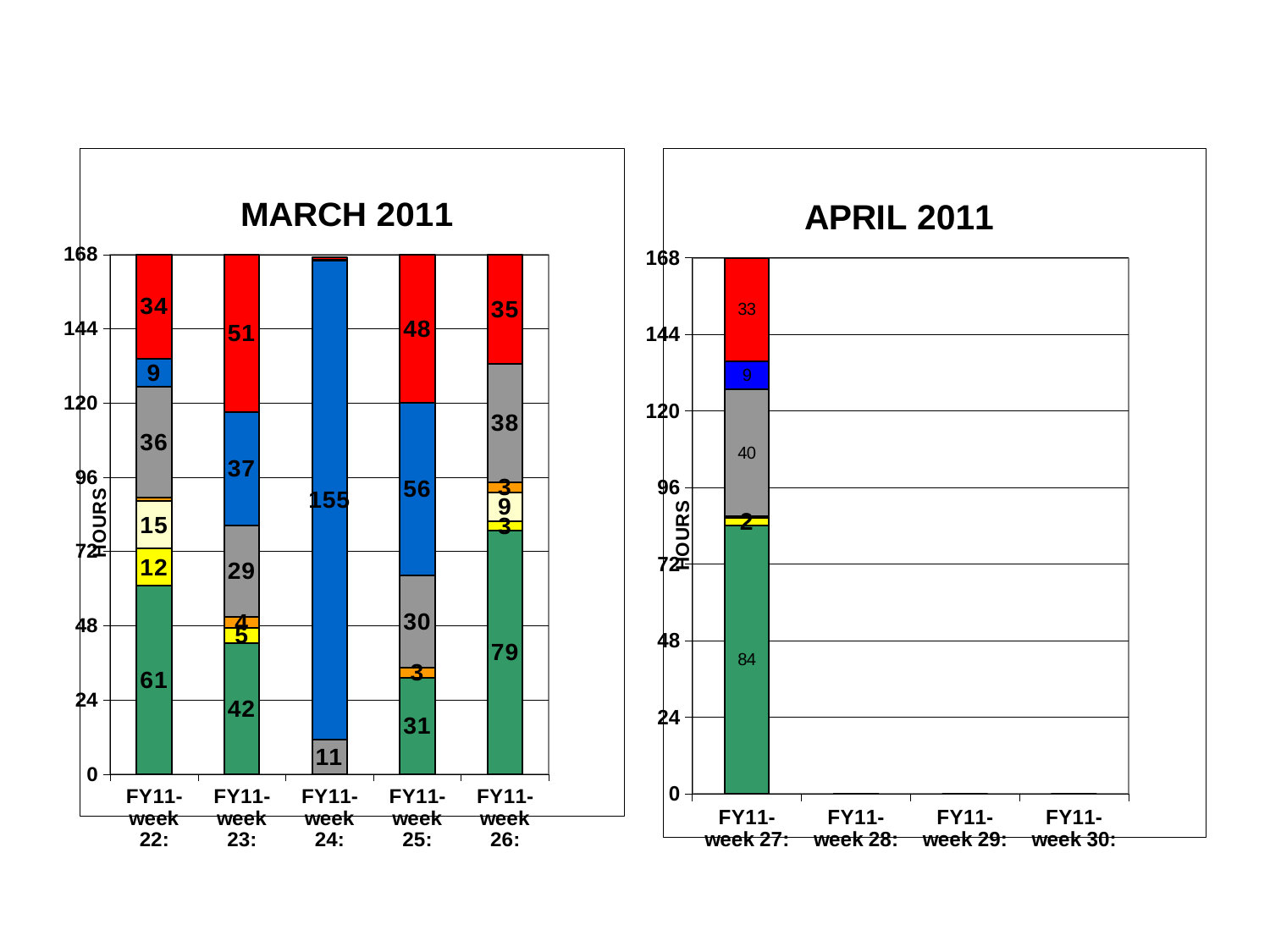
In the MARCH 2011 chart, what is the value of the green segment for FY11-week 22? 61 What is the title of the chart on the right side of the slide? APRIL 2011 In the APRIL 2011 chart, what is the value of the green segment for FY11-week 27? 84 In the APRIL 2011 chart, what is the value of the red segment for FY11-week 27? 33 In the MARCH 2011 chart, which week has the largest green segment? FY11-week 26 How many weeks are shown on the x axis of the MARCH 2011 chart? 5 In the MARCH 2011 chart, what is the value of the red segment for FY11-week 23? 51 In the MARCH 2011 chart, is the red segment larger for FY11-week 25 or FY11-week 22? FY11-week 25 In the MARCH 2011 chart, what is the difference between the gray segment for FY11-week 26 and the gray segment for FY11-week 25? 8 In the MARCH 2011 chart, what is the value of the blue segment for FY11-week 24? 155 What type of chart is the MARCH 2011 chart? Stacked bar chart How many weeks are shown on the x axis of the APRIL 2011 chart? 4